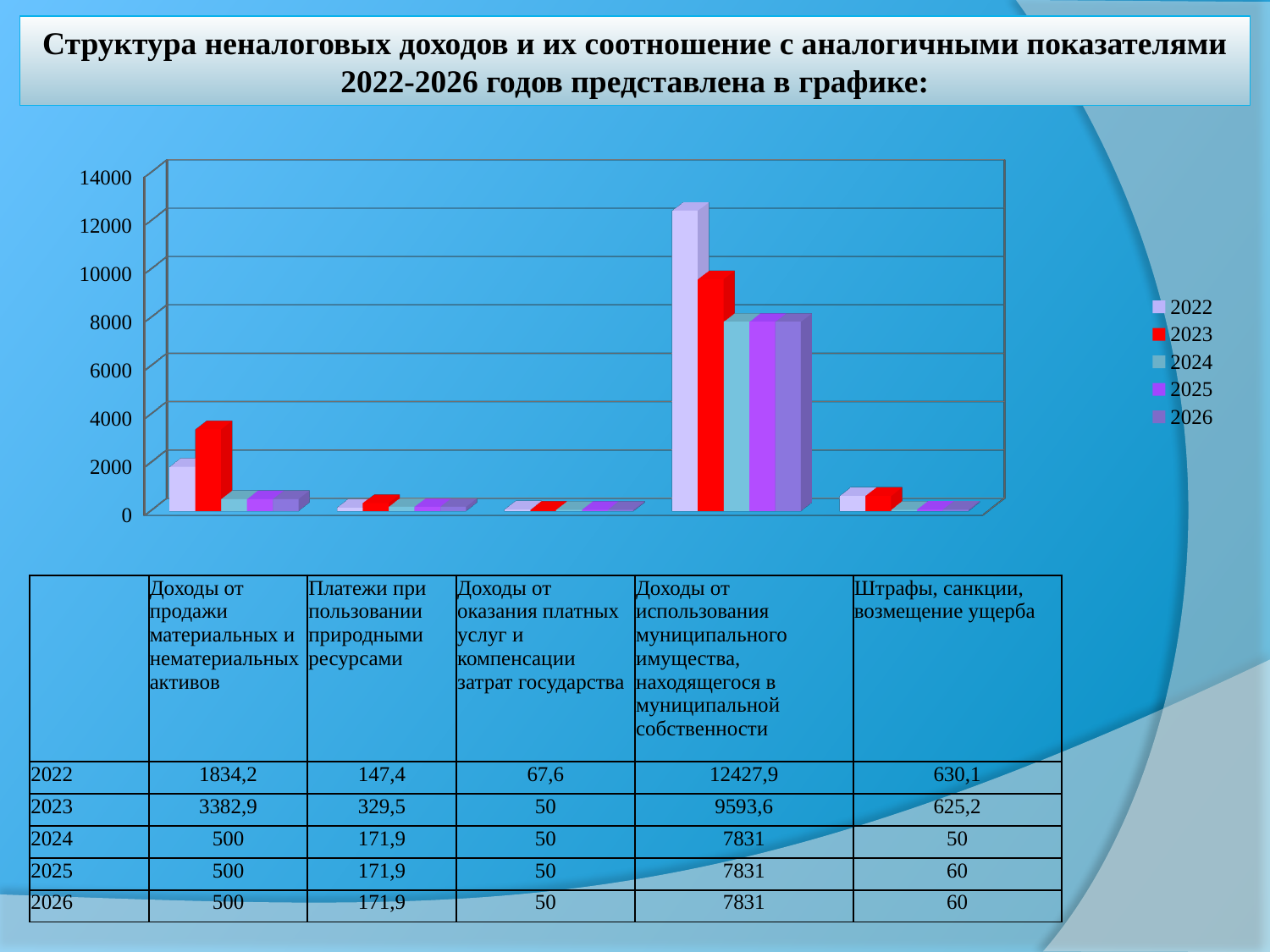
Which category has the highest value in 2022? Доходы от использования муниципального имущества, находящегося в муниципальной собственности Which colour represents the 2023 series in the chart legend? red Which category has the lowest value in 2022? Доходы от оказания платных услуг и компенсации затрат государства How many categories (groups of bars) are plotted in the chart? 5 Which is larger for 'Платежи при пользовании природными ресурсами': the 2023 value or the 2024 value? 2023 What is the difference between the 2022 and 2023 values for 'Доходы от использования муниципального имущества, находящегося в муниципальной собственности'? 2834,3 What kind of chart is shown on the slide? bar chart According to the table, what is the value for 'Доходы от использования муниципального имущества, находящегося в муниципальной собственности' in 2022? 12427,9 Is the 2022 bar for 'Доходы от использования муниципального имущества' greater or less than 12000? greater According to the table, what is the value for 'Штрафы, санкции, возмещение ущерба' in 2024? 50 How many series does the chart legend list? 5 According to the table, what is the value for 'Доходы от продажи материальных и нематериальных активов' in 2023? 3382,9